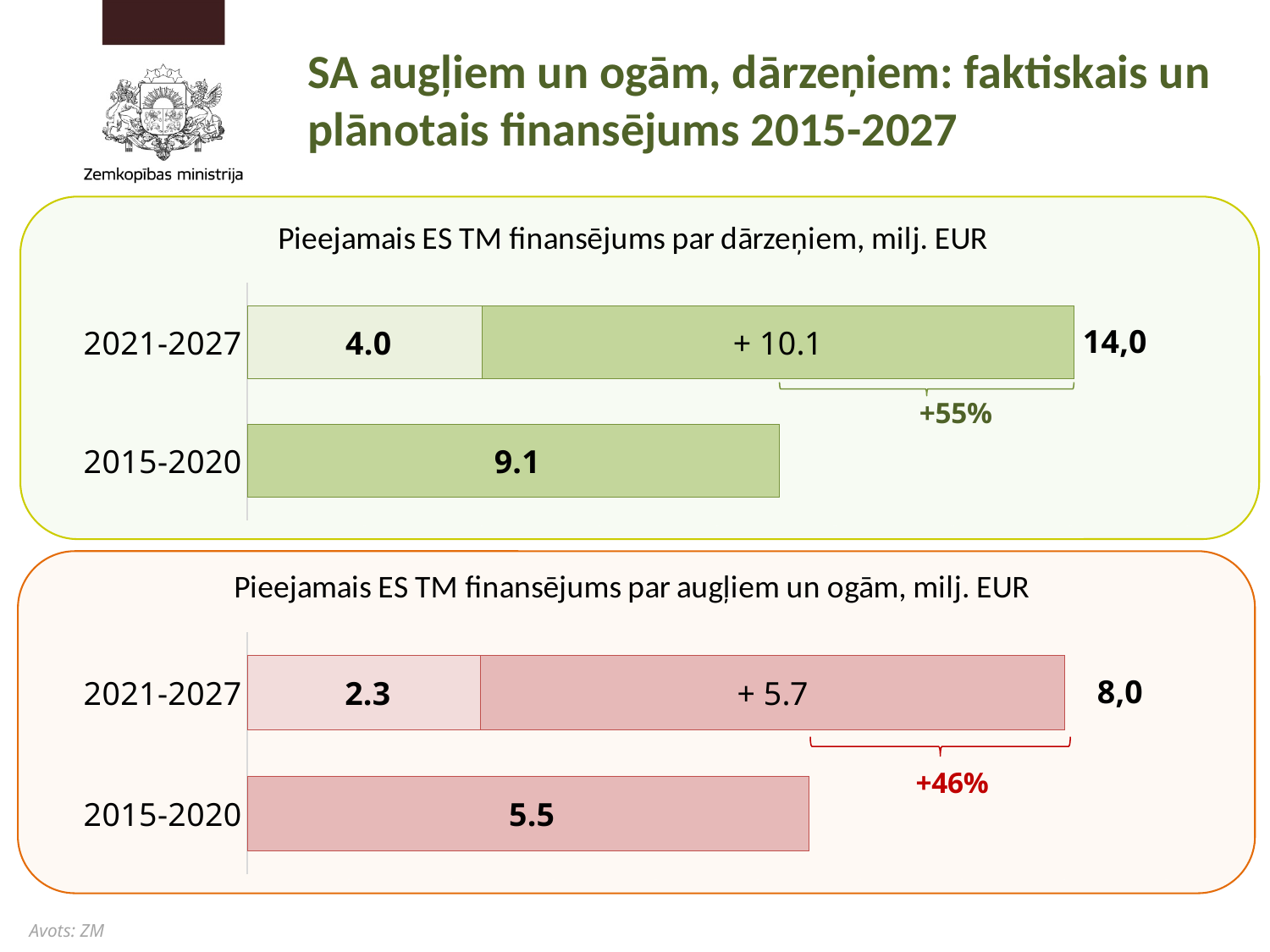
In the top chart (Pieejamais ES TM finansējums par dārzeņiem), what is the value of the first segment of the 2021-2027 bar? 4.0 In the bottom chart (Pieejamais ES TM finansējums par augļiem un ogām), what is the value of the first segment of the 2021-2027 bar? 2.3 In the top chart (Pieejamais ES TM finansējums par dārzeņiem), what is the value of the added segment of the 2021-2027 bar? + 10.1 In the bottom chart (Pieejamais ES TM finansējums par augļiem un ogām), what is the total shown for the 2021-2027 bar? 8,0 In the bottom chart (Pieejamais ES TM finansējums par augļiem un ogām), what percentage increase is annotated next to the 2021-2027 bar? +46% In the bottom chart (Pieejamais ES TM finansējums par augļiem un ogām), what is the difference between the 2015-2020 value and the first segment of the 2021-2027 bar? 3.2 In the top chart (Pieejamais ES TM finansējums par dārzeņiem), which period has the longer bar, 2021-2027 or 2015-2020? 2021-2027 What kind of chart is the bottom chart (Pieejamais ES TM finansējums par augļiem un ogām)? Bar chart In the top chart (Pieejamais ES TM finansējums par dārzeņiem), what percentage increase is annotated next to the 2021-2027 bar? +55% In the top chart (Pieejamais ES TM finansējums par dārzeņiem), what is the total shown for the 2021-2027 bar? 14,0 In the bottom chart (Pieejamais ES TM finansējums par augļiem un ogām), what is the value for 2015-2020? 5.5 In the top chart (Pieejamais ES TM finansējums par dārzeņiem), what is the value for 2015-2020? 9.1